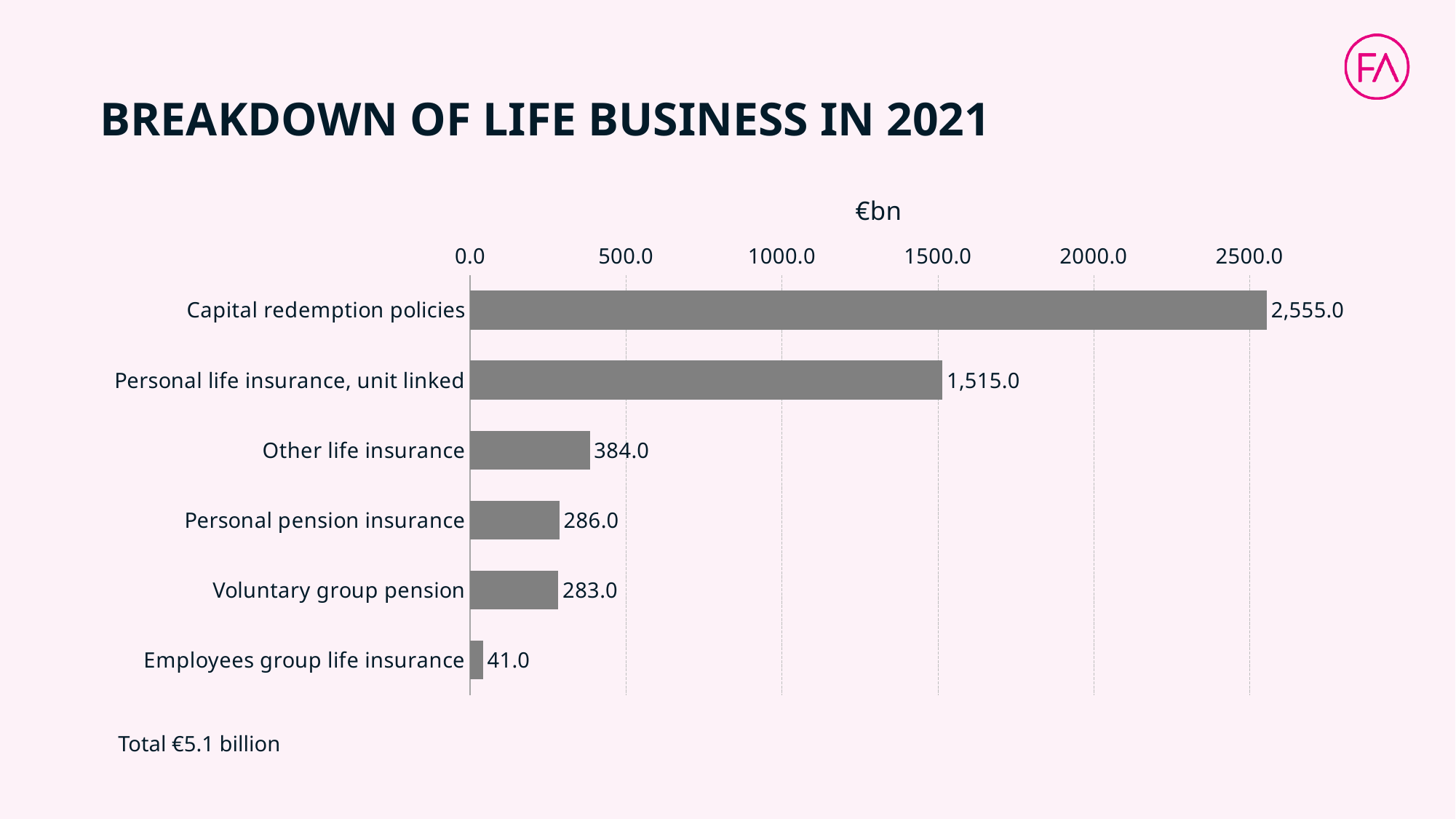
What is the value for Other life insurance? 384.0 What is the value for Employees group life insurance? 41.0 How many categories are shown in the chart? 6 What is the difference between Personal pension insurance and Voluntary group pension? 3.0 What is the value for Capital redemption policies? 2,555.0 Which category has the highest value? Capital redemption policies Which is larger, Other life insurance or Personal pension insurance? Other life insurance What kind of chart is shown on the slide? Bar chart What is the difference between Capital redemption policies and Personal life insurance, unit linked? 1,040.0 What unit is shown above the chart's axis? €bn What is the value for Personal life insurance, unit linked? 1,515.0 Which category has the lowest value? Employees group life insurance